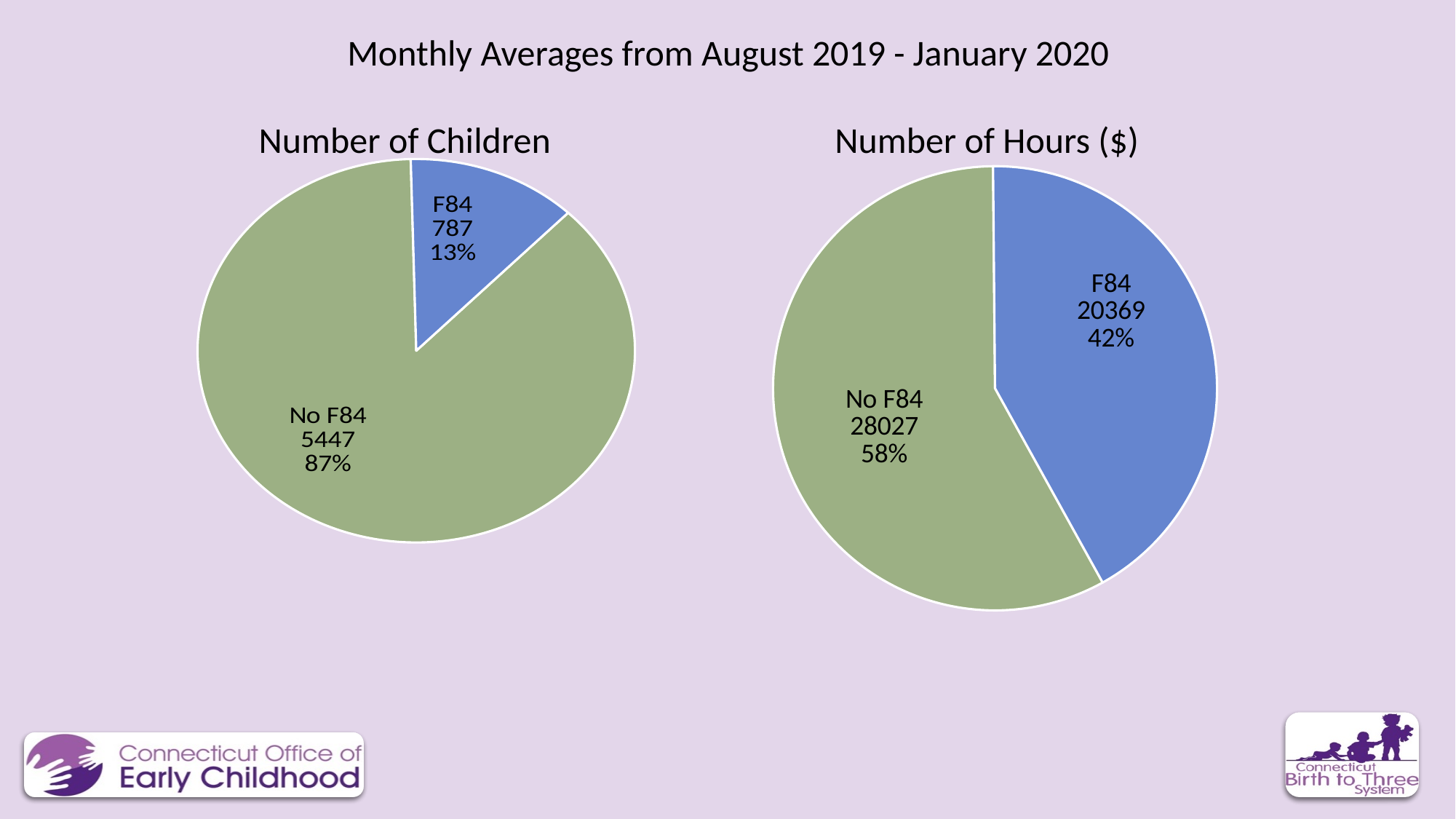
In the 'Number of Children' chart, which category is the largest? No F84 In the 'Number of Hours ($)' chart, what is the value for F84? 20369 In the 'Number of Hours ($)' chart, what is the difference between the No F84 and F84 values? 7658 What kind of chart is the 'Number of Hours ($)' chart? Pie chart In the 'Number of Hours ($)' chart, what is the value for No F84? 28027 In the 'Number of Children' chart, what share of the pie does the F84 slice represent? 13% How many slices does the 'Number of Children' pie chart have? 2 In the 'Number of Hours ($)' chart, what share of the pie does the No F84 slice represent? 58% In the 'Number of Hours ($)' chart, which category is the smallest? F84 In the 'Number of Children' chart, what is the value for No F84? 5447 In the 'Number of Children' chart, what is the value for F84? 787 In the 'Number of Children' chart, what is the difference between the No F84 and F84 values? 4660